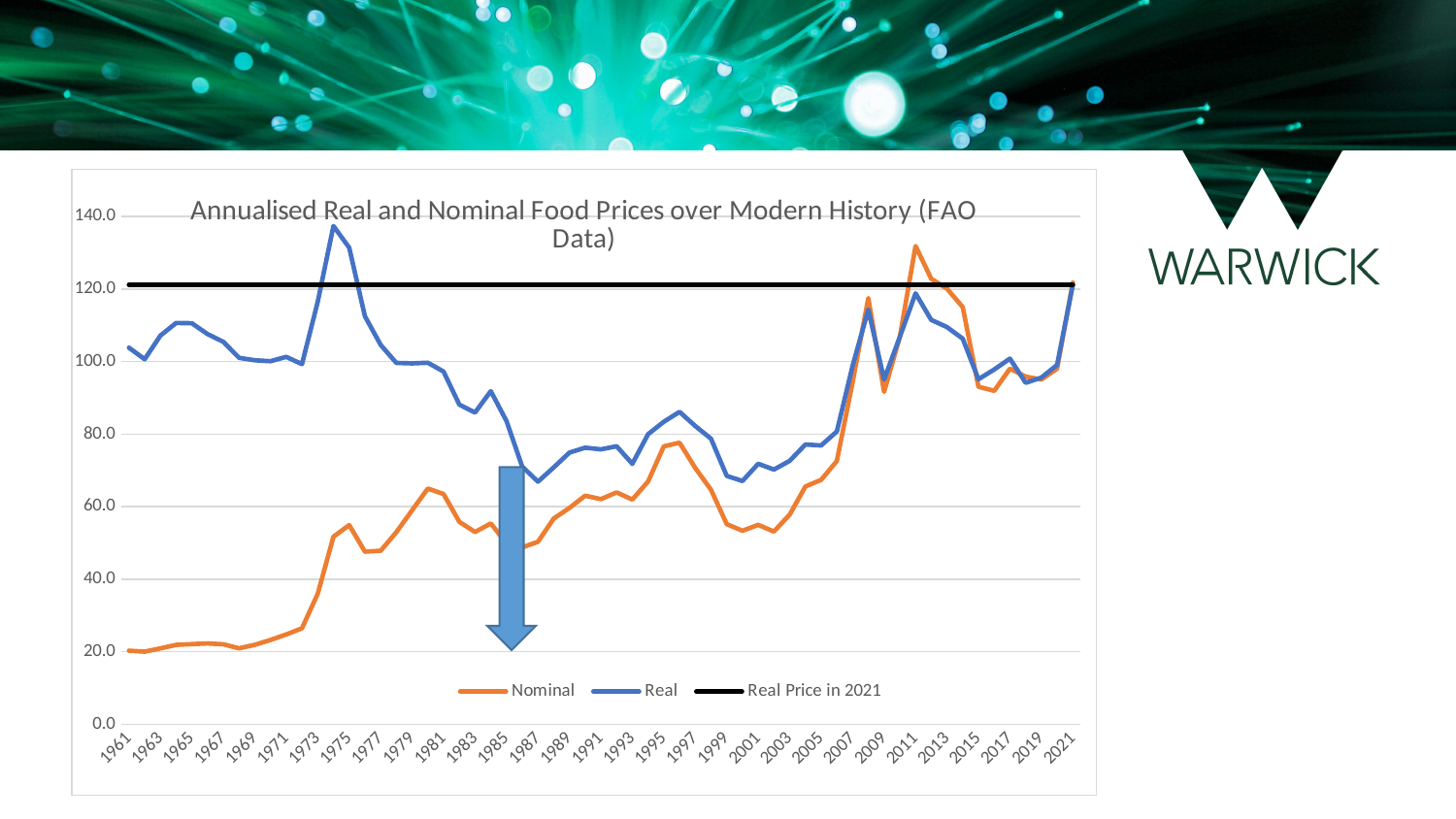
What are the three series named in the legend? Nominal, Real, Real Price in 2021 In 1975, which series has the larger value, Nominal or Real? Real In which year does the Real series reach its highest value? 1974 Does the Nominal series rise or fall between 1961 and 1975? Rise In 2011, which series has the larger value, Nominal or Real? Nominal Is the Real value for 1975 greater or less than 120? greater Is the Nominal value for 2011 greater or less than 120? greater Is the Nominal value for 1961 greater or less than 40? less How many series does the legend list? 3 What kind of chart is shown on the slide? Line chart What is the title of the chart? Annualised Real and Nominal Food Prices over Modern History (FAO Data)